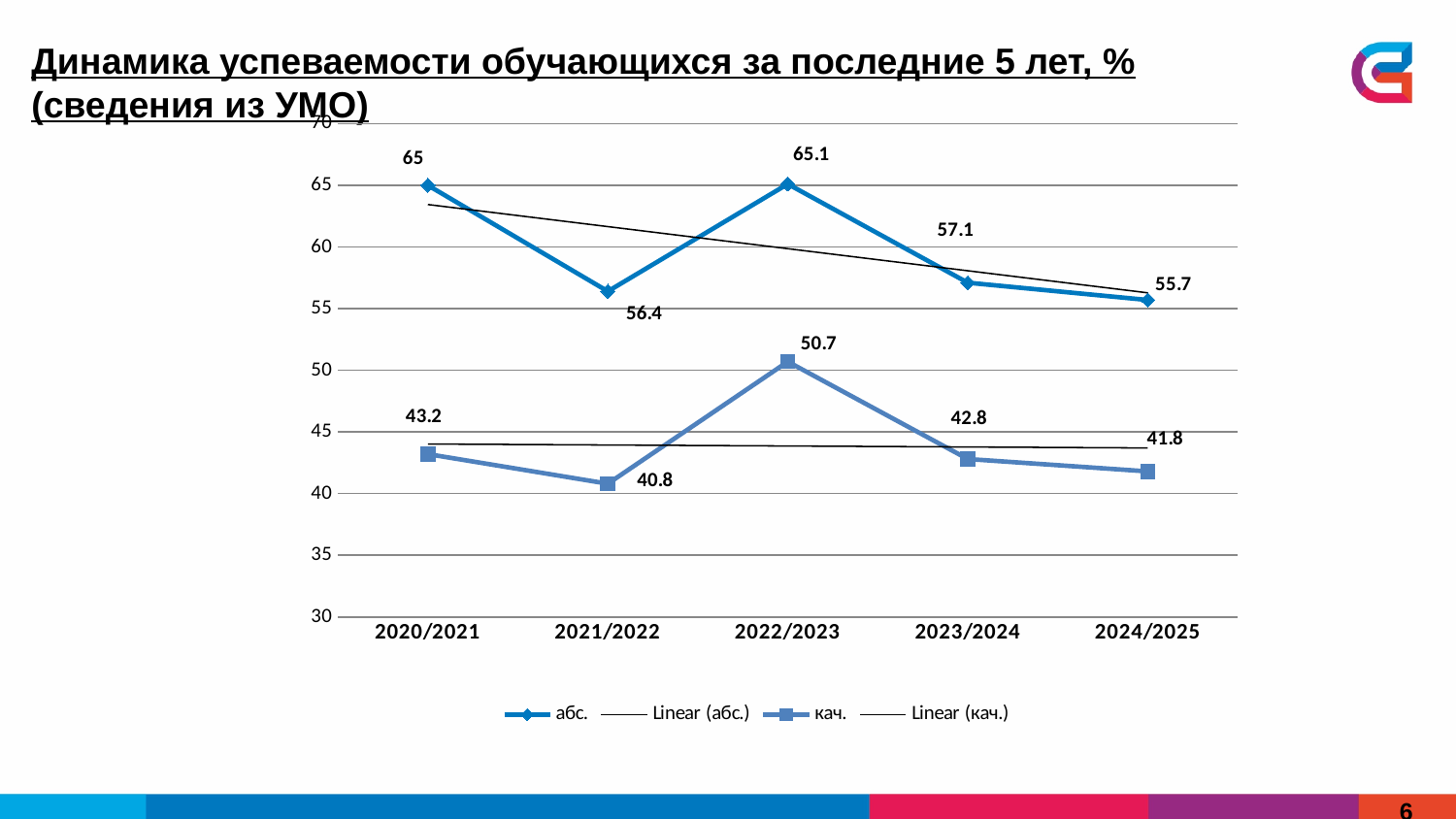
What is the value of the абс. series for 2022/2023? 65.1 What is the difference between the абс. and кач. values for 2020/2021? 21.8 In which year is the абс. series lowest? 2024/2025 Is the абс. value for 2021/2022 greater or less than 60? less What kind of chart is shown on the slide? line chart Which is larger: the кач. value for 2023/2024 or for 2024/2025? 2023/2024 What is the value of the кач. series for 2021/2022? 40.8 In which year is the кач. series highest? 2022/2023 How many academic years are shown on the x axis? 5 Does the кач. series rise or fall from 2022/2023 to 2024/2025? fall How many entries does the legend list? 4 What is the value of the абс. series for 2024/2025? 55.7